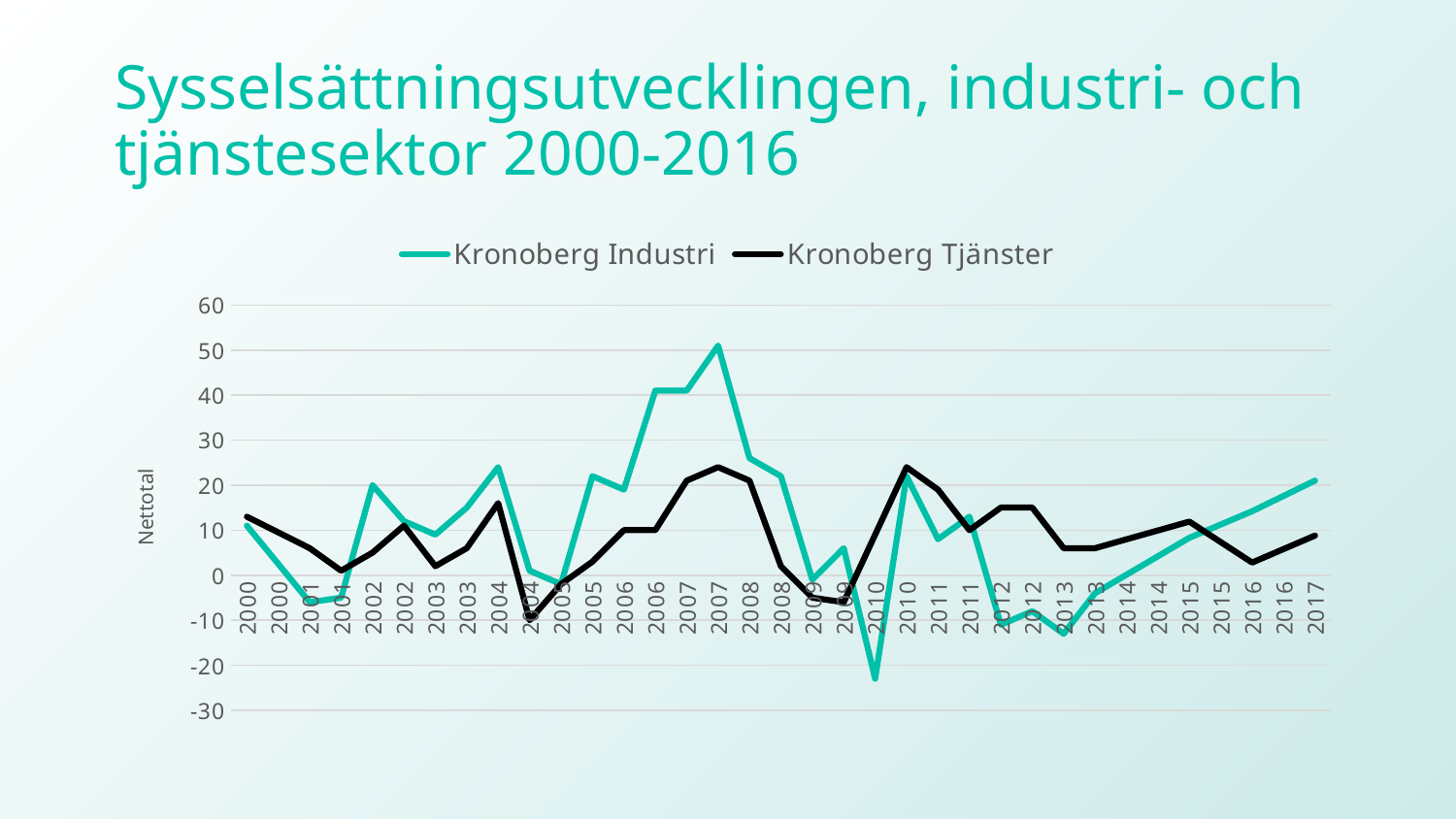
In which year does the Kronoberg Industri series reach its lowest value? 2010 Which colour is used for the Kronoberg Tjänster series? black How many series does the legend list? 2 In which year does the Kronoberg Industri series reach its highest value? 2007 Is the lowest value of Kronoberg Industri in 2010 greater or less than -10? less What kind of chart is shown on the slide? line chart Is the peak value of Kronoberg Industri in 2007 greater or less than 40? greater Which series reaches the highest value on the chart? Kronoberg Industri Does the Kronoberg Industri series rise or fall from 2013 to 2017? rise At the 2007 peak, which series has the larger value, Kronoberg Industri or Kronoberg Tjänster? Kronoberg Industri At the 2017 point, which series has the larger value, Kronoberg Industri or Kronoberg Tjänster? Kronoberg Industri What is the label on the vertical axis? Nettotal